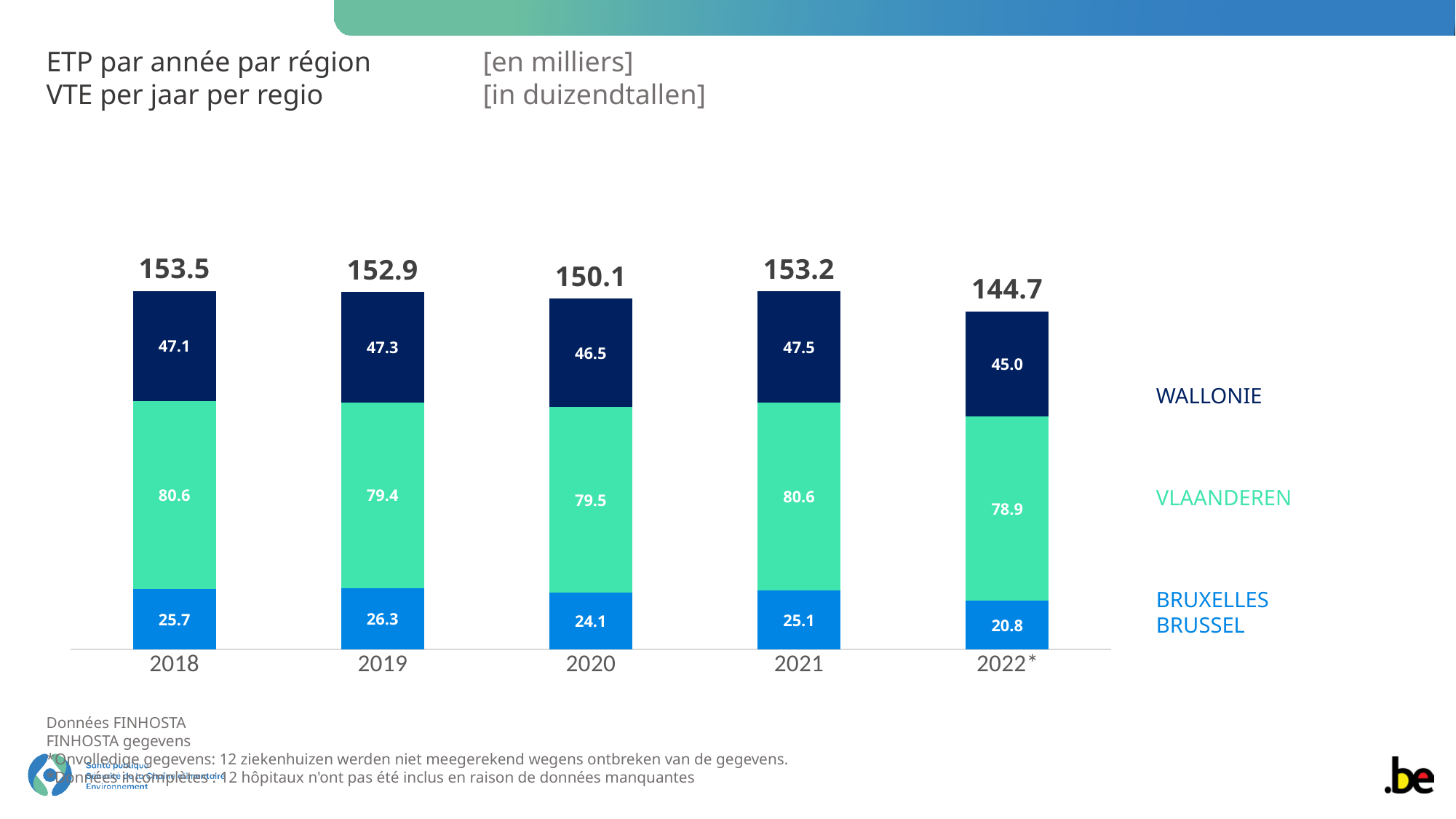
Which year has the highest total? 2018 How many series does the legend list? 3 What is the value for Vlaanderen in 2022*? 78.9 What is the value for Wallonie in 2020? 46.5 What kind of chart is shown on the slide? Stacked bar chart What is the difference between the Wallonie values for 2021 and 2022*? 2.5 Which is larger, the Bruxelles/Brussel value in 2018 or in 2022*? 2018 Which series is shown in dark navy blue at the top of each bar? WALLONIE What is the total of the stacked bar for 2021? 153.2 How many years are shown on the x axis? 5 What is the value for Bruxelles/Brussel in 2019? 26.3 Which year has the lowest total? 2022*